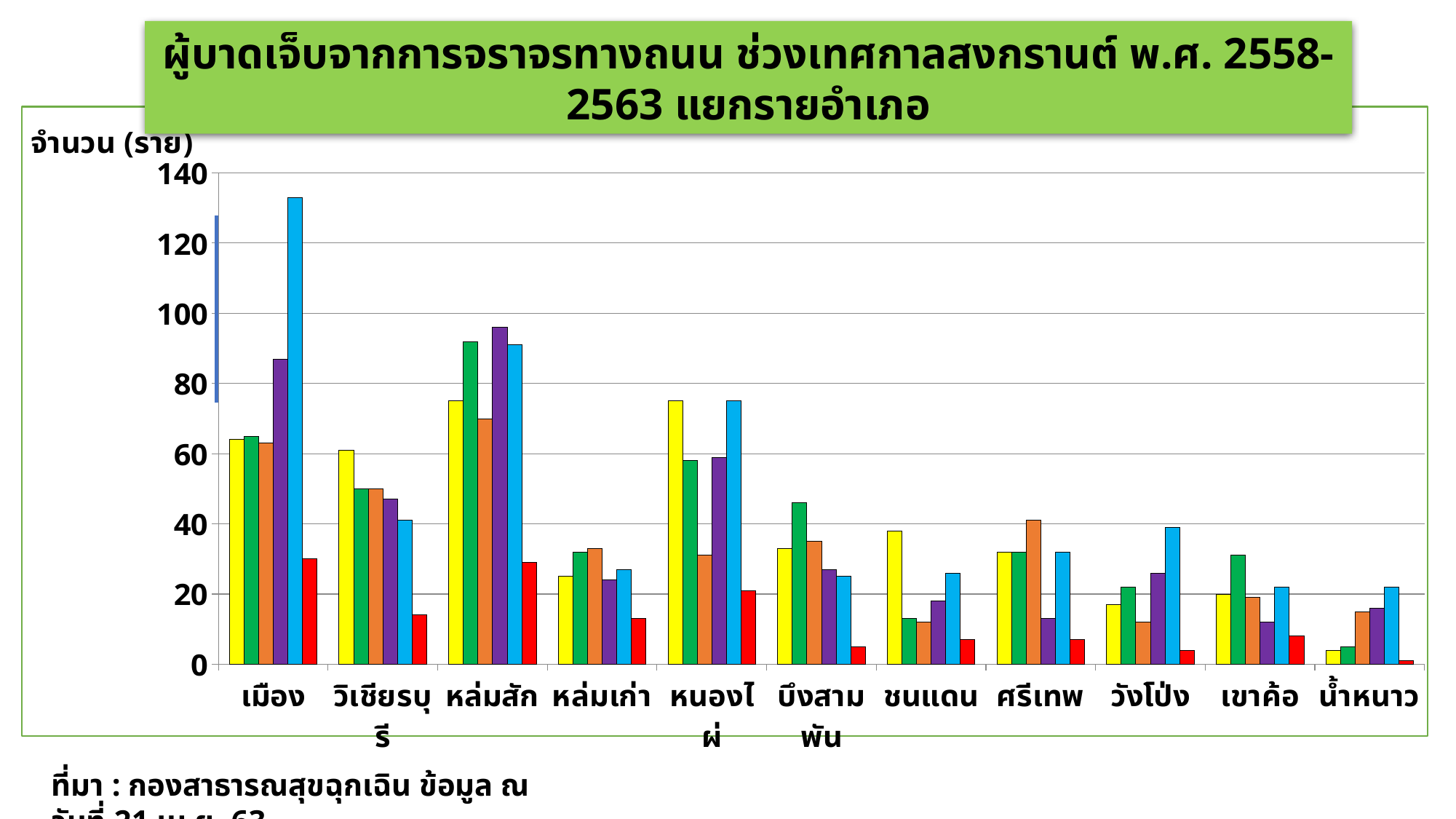
Is the value of the light-blue bar for เมือง greater or less than 120? greater Is the value of the purple bar for หล่มสัก greater or less than 80? greater How many bars are plotted for each district? 6 What is the label on the y axis of the chart? จำนวน (ราย) How many districts (categories) are shown on the x axis? 11 Is the value of the light-blue bar for ศรีเทพ greater or less than 40? less Which is larger: the light-blue bar for เมือง or the light-blue bar for หล่มสัก? เมือง Which district has the lowest bars overall? น้ำหนาว Which district has the tallest bar in the chart? เมือง What kind of chart is shown on the slide? bar chart